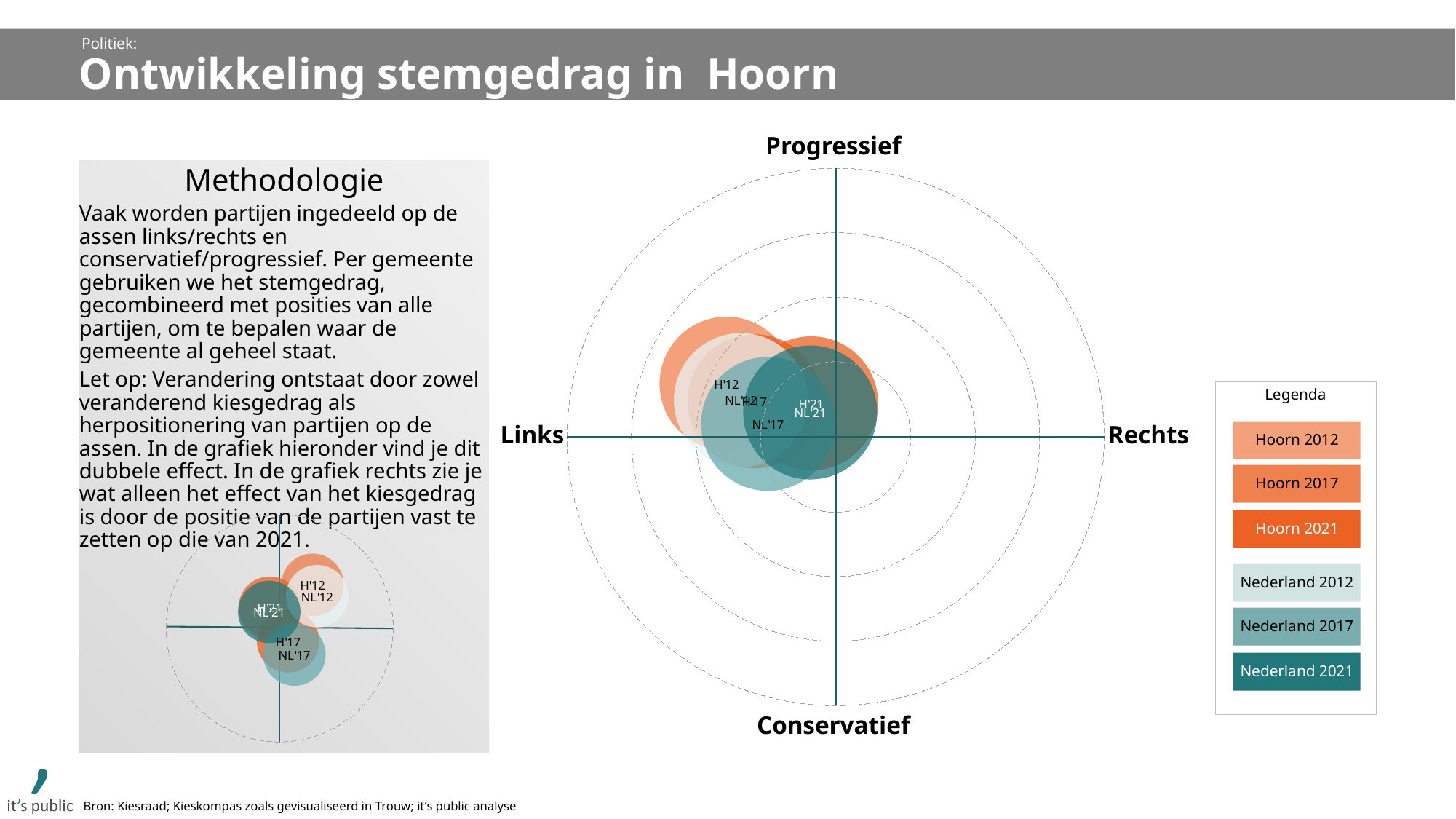
How many charts are shown on the slide? 2 What kind of chart is the large chart in the centre of the slide? bubble chart Which legend entry is shown in the darkest teal colour? Nederland 2021 In the large central chart, is the Hoorn 2012 bubble in the Progressief or the Conservatief half? Progressief In the large central chart, what is the label at the bottom of the vertical axis? Conservatief Which legend entry is shown in the darkest orange colour? Hoorn 2021 In the large central chart, what label appears at the left end of the horizontal axis? Links How many years are compared in the legend for Hoorn? 3 In the large central chart, is the Hoorn 2012 bubble on the Links or the Rechts side of the vertical axis? Links In the large central chart, what is the label at the top of the vertical axis? Progressief How many entries does the legend (Legenda) list? 6 In the large central chart, what label appears at the right end of the horizontal axis? Rechts